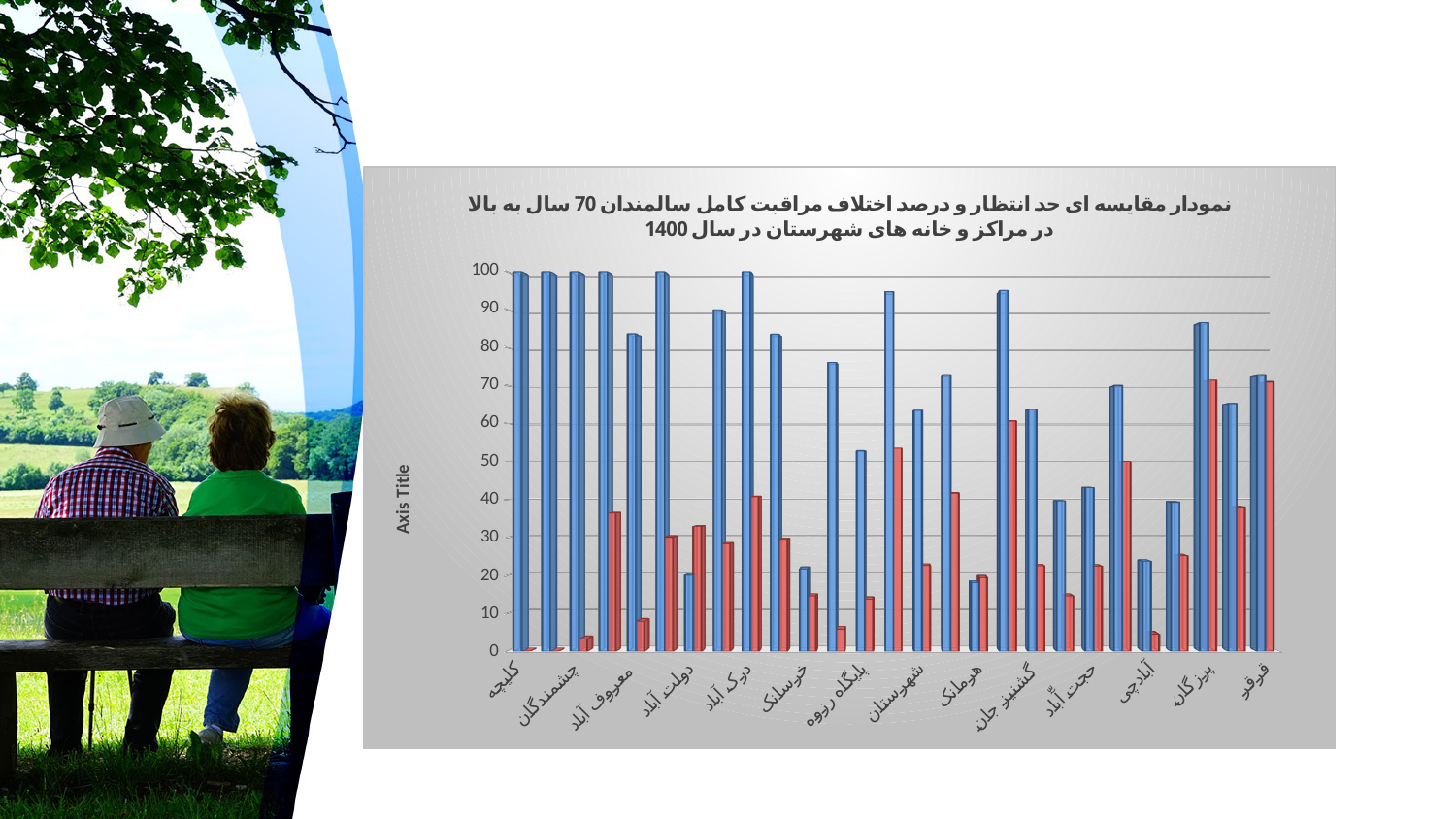
What kind of chart is shown on the slide? bar chart What is the highest value shown on the vertical axis of the chart? 100 Is the blue bar for کلیچه greater or less than 90? greater What is the vertical axis title of the chart? Axis Title For کلیچه, which bar is larger, the blue bar or the red bar? the blue bar Is the red bar for کلیچه greater or less than 10? less